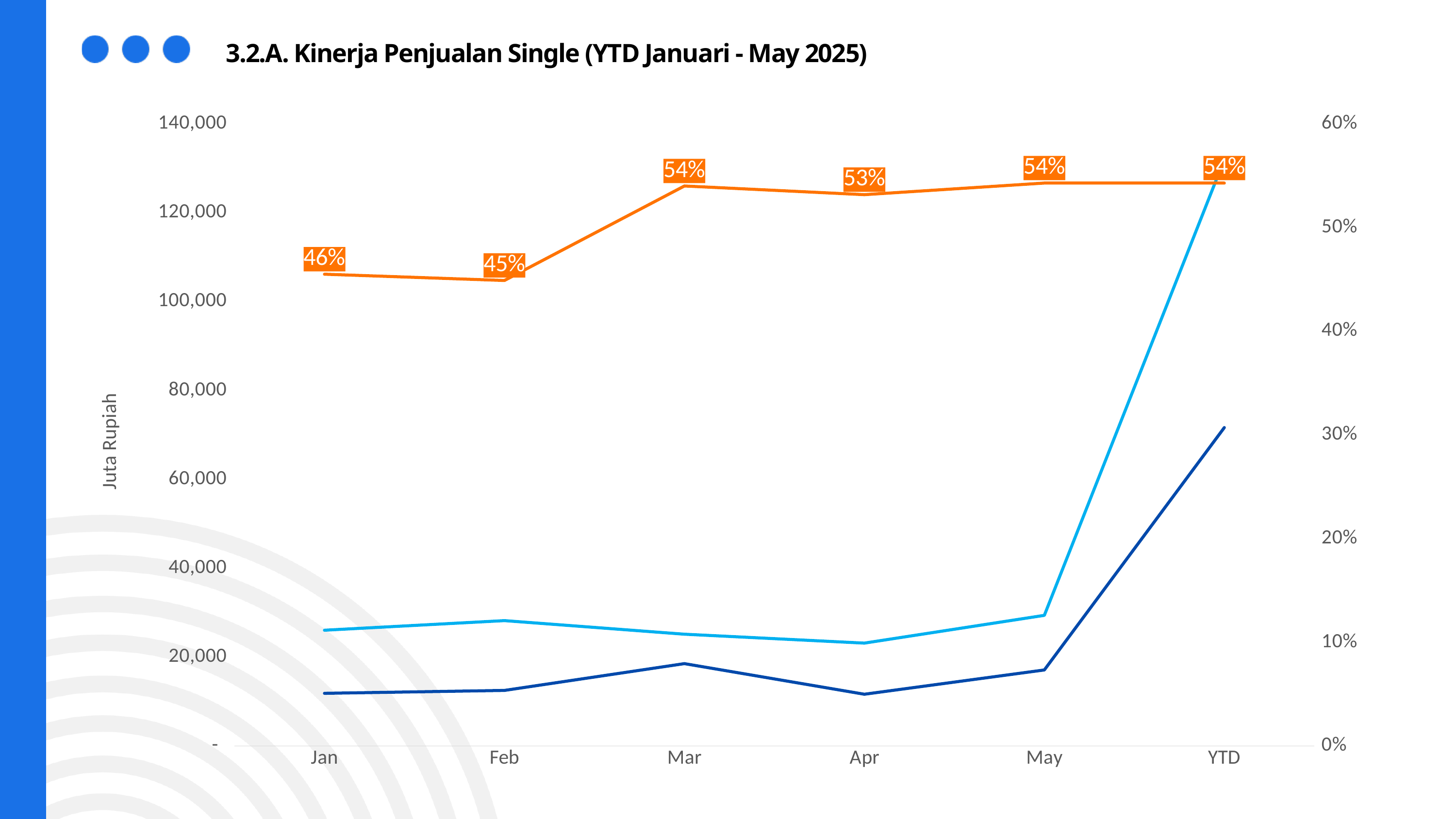
Is the value of the light blue line at YTD greater or less than 120,000 on the left axis? greater How many categories are shown on the x axis? 6 Is the value of the dark blue line at Jan greater or less than 20,000 on the left axis? less What is the value labelled on the orange line for Apr? 53% What is the difference between the orange line's labelled values for Mar and Feb? 9% What type of chart is shown on the slide? line chart In which category does the orange line have its lowest labelled value? Feb Is the orange line's labelled value higher for Jan or for Feb? Jan What is the value labelled on the orange line for YTD? 54% What is the label on the left vertical axis? Juta Rupiah What is the value labelled on the orange line for Feb? 45% What is the value labelled on the orange line for Jan? 46%